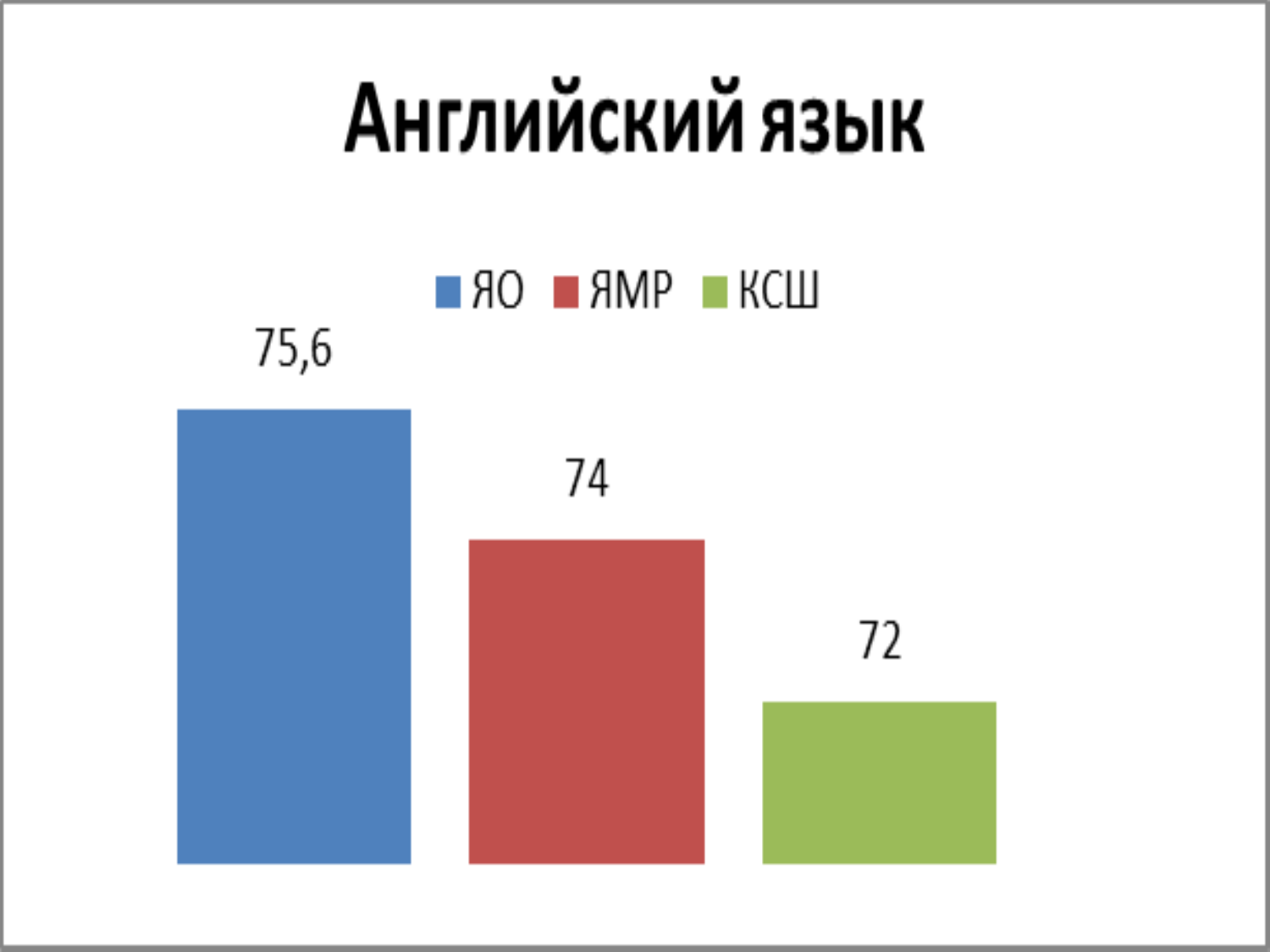
What is the difference between the values for ЯО and ЯМР? 1,6 What kind of chart is shown on the slide? bar chart Which series has the highest value? ЯО How many series does the legend list? 3 Which series has the lowest value? КСШ What is the value for ЯО? 75,6 What is the difference between the values for ЯМР and КСШ? 2 What is the value for КСШ? 72 How many bars are plotted on the chart? 3 Which is larger, the value for ЯО or the value for КСШ? ЯО What is the title of the chart? Английский язык What is the value for ЯМР? 74